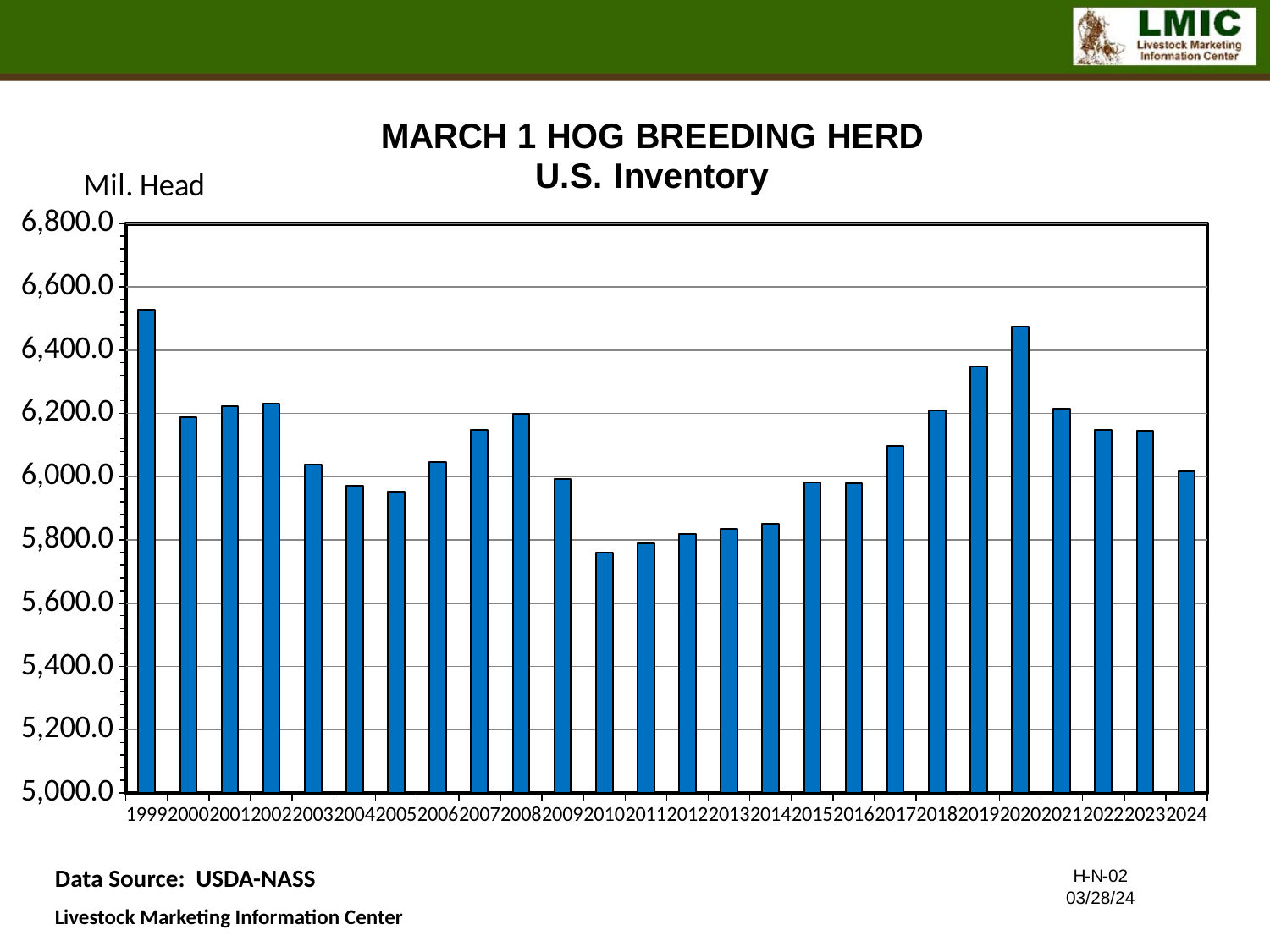
Is the value for 2020 greater or less than 6,400.0? greater Is the value for 2010 greater or less than 5,800.0? less What unit is shown on the y axis of the chart? Mil. Head Which is larger, the value for 2019 or the value for 2018? 2019 Is the value for 2019 greater or less than 6,200.0? greater Which is larger, the value for 2020 or the value for 2010? 2020 Do the values generally rise or fall from 2010 to 2020? rise Which year has the highest March 1 hog breeding herd inventory? 1999 What kind of chart is shown on the slide? bar chart How many years are plotted on the chart? 26 Which year has the lowest March 1 hog breeding herd inventory? 2010